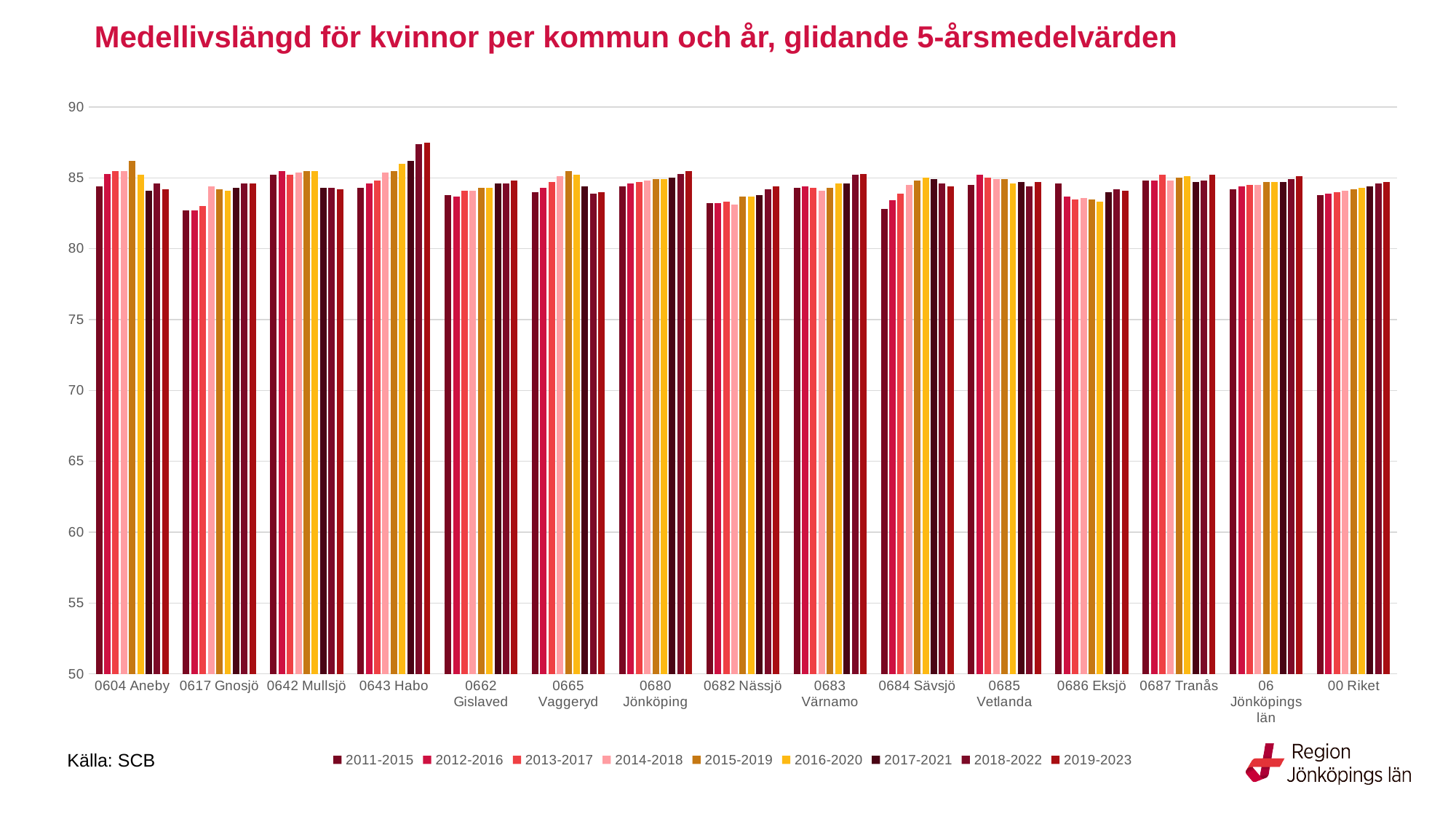
What source is cited for the chart? SCB Which category has the highest value for the 2019-2023 series? 0643 Habo Is the value for 0604 Aneby in 2015-2019 greater or less than 85? greater Do the values for 0643 Habo rise or fall from the 2011-2015 series to the 2019-2023 series? rise Is the value for 0617 Gnosjö in 2011-2015 greater or less than 85? less Which is larger for the 2019-2023 series: 0643 Habo or 0617 Gnosjö? 0643 Habo How many categories (municipalities/regions) are shown on the x axis? 15 Is the value for 0643 Habo in 2019-2023 greater or less than 85? greater What is the title of the chart? Medellivslängd för kvinnor per kommun och år, glidande 5-årsmedelvärden What kind of chart is shown on the slide? bar chart How many series does the legend list? 9